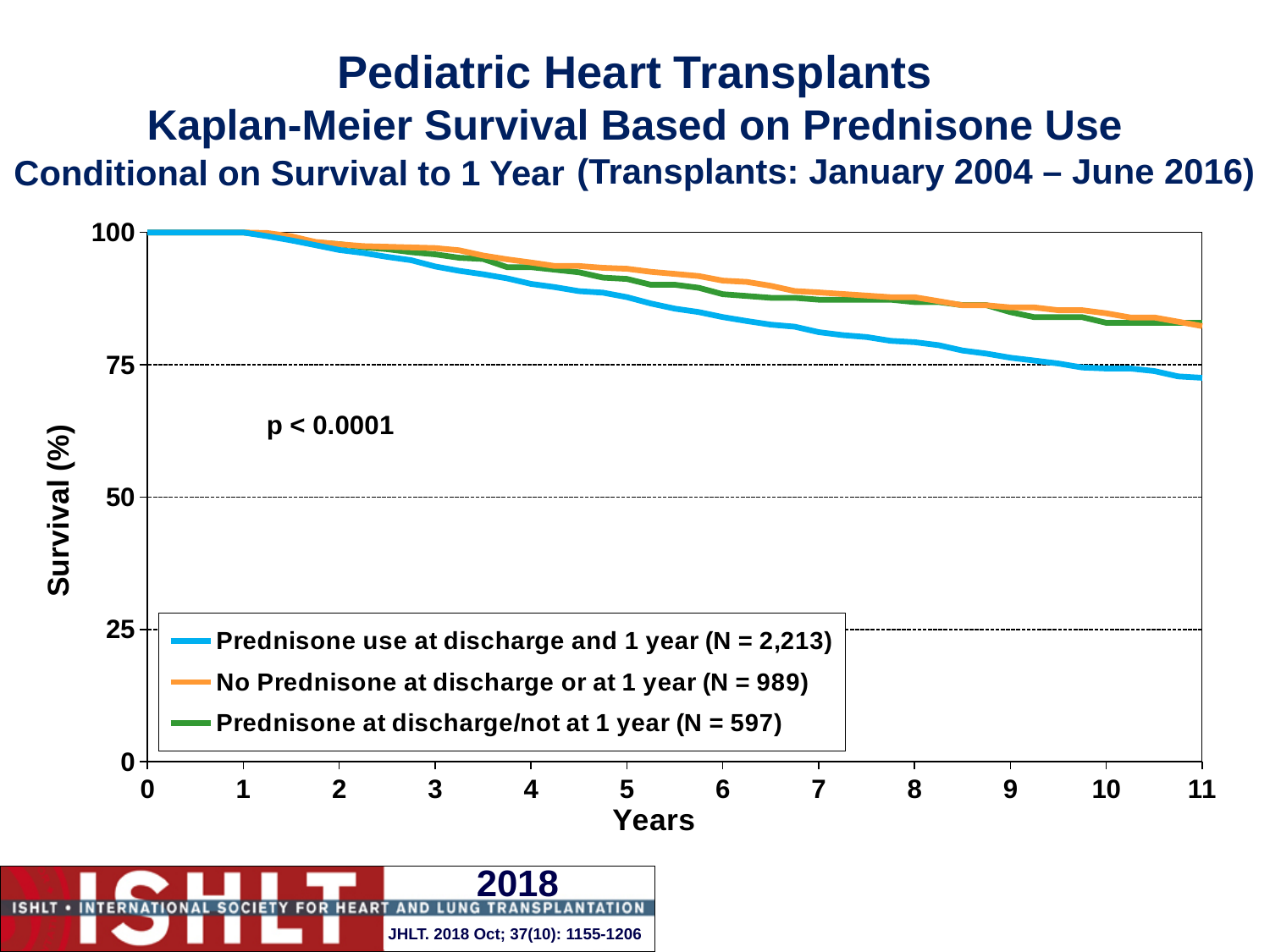
Which group has the lowest survival at year 11? Prednisone use at discharge and 1 year (N = 2,213) What kind of chart is shown on the slide? line chart What p-value is printed on the chart? p < 0.0001 What is the survival value for all three groups at year 1? 100 Is the survival value for 'No Prednisone at discharge or at 1 year' at year 11 greater or less than 75? greater Do the survival curves rise or fall as years increase? fall How many series does the legend list? 3 At year 11, which is higher: the survival for 'No Prednisone at discharge or at 1 year' or for 'Prednisone use at discharge and 1 year'? No Prednisone at discharge or at 1 year What is the N for the 'Prednisone at discharge/not at 1 year' group? 597 How many tick marks are labelled on the Years axis? 12 Is the survival value for 'Prednisone at discharge/not at 1 year' at year 6 greater or less than 75? greater Is the survival value for 'Prednisone use at discharge and 1 year' at year 11 greater or less than 75? less